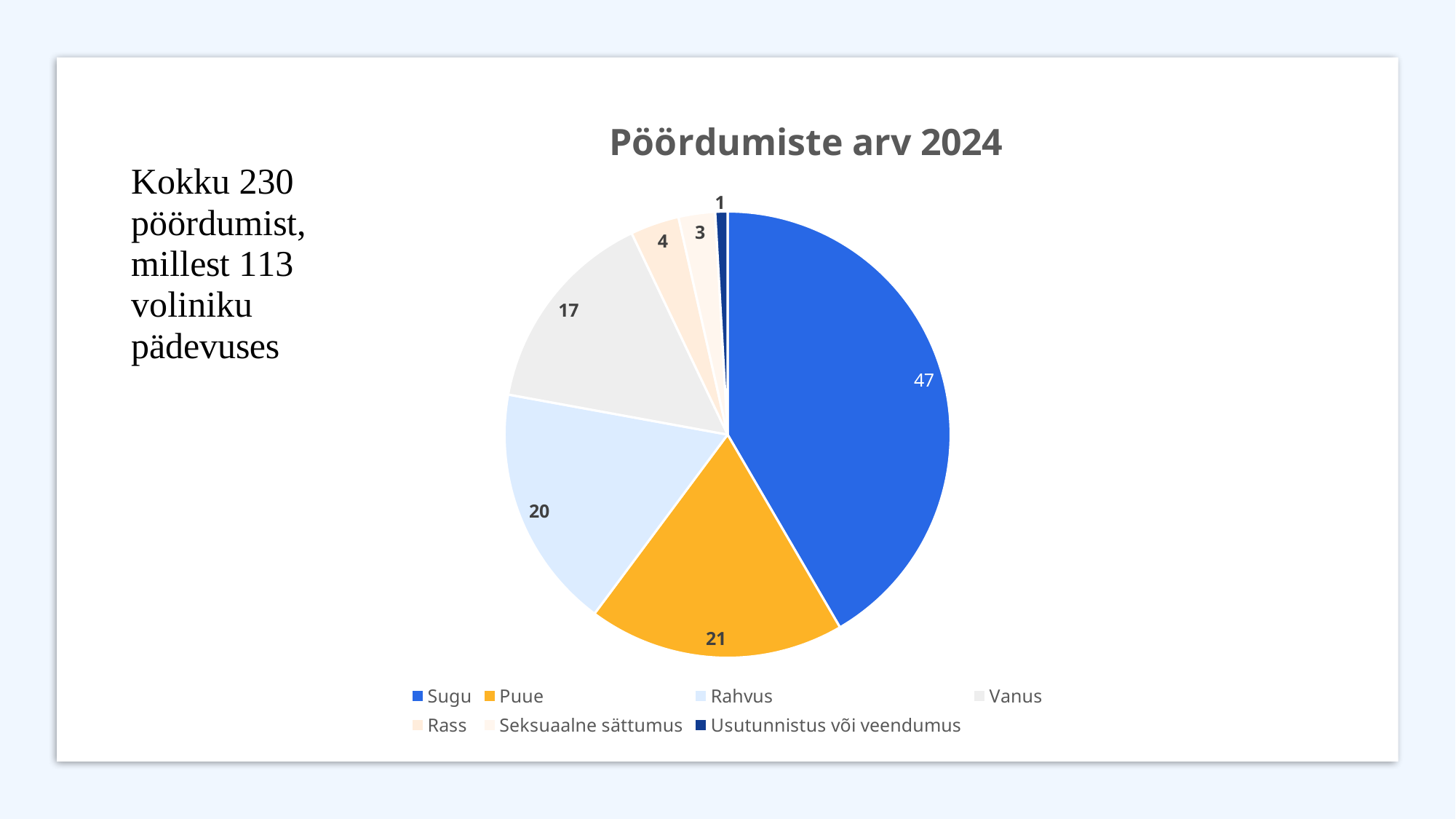
What is the value for Puue? 21 What is the value for Usutunnistus või veendumus? 1 Which category has the largest slice? Sugu What is the difference between the values for Sugu and Rahvus? 27 What type of chart is shown on the slide? pie chart How many categories does the pie chart have? 7 What is the title of the chart? Pöördumiste arv 2024 What is the total of all the slices in the pie chart? 113 Which category has the smallest slice? Usutunnistus või veendumus What is the value for Vanus? 17 Which is larger, the value for Vanus or the value for Rass? Vanus What is the value for Sugu? 47